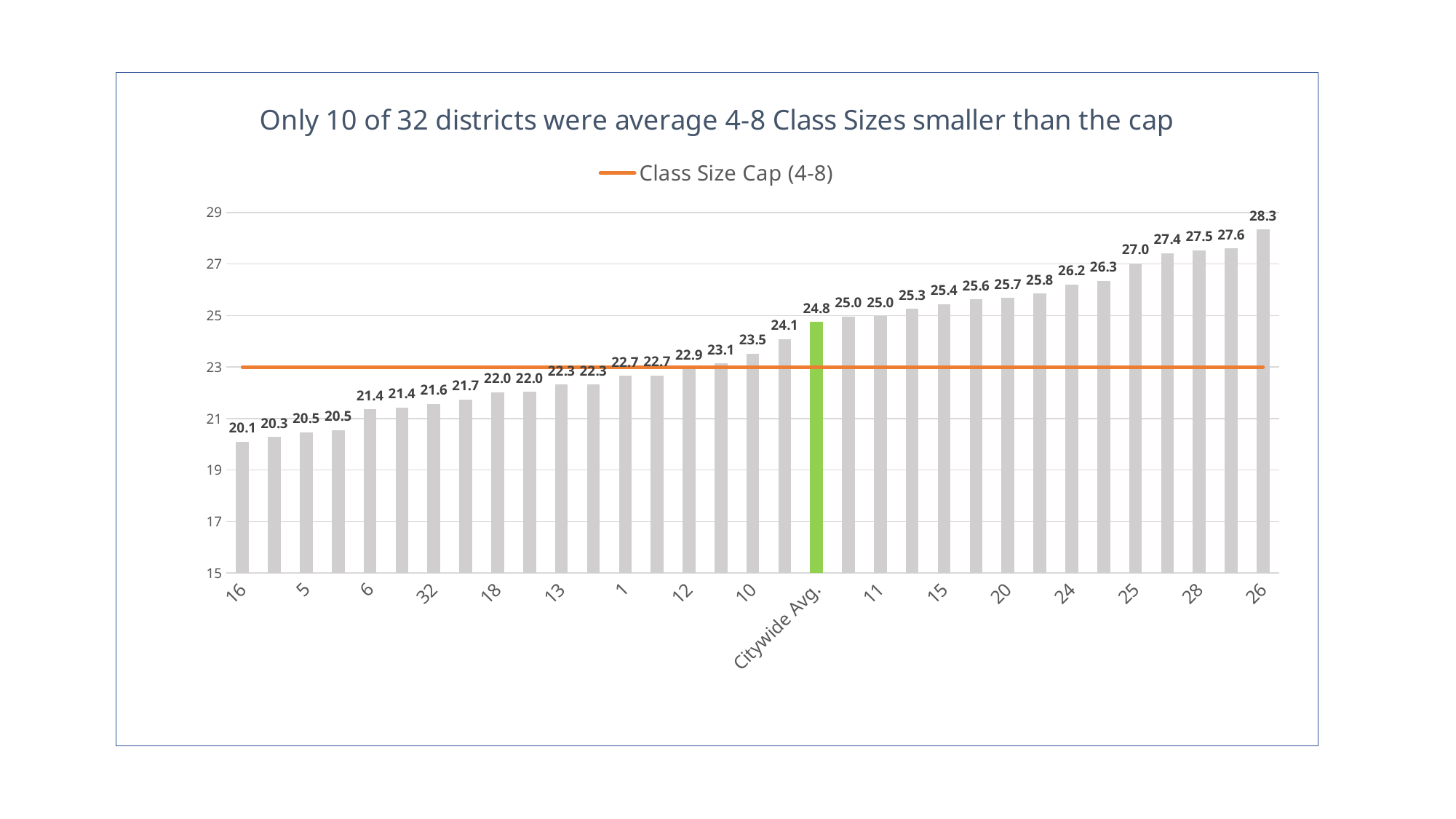
Is the value for district 6 greater or less than 23? less What is the value shown for the Citywide Avg. bar? 24.8 Do the bar values rise or fall from left to right along the x axis? rise What kind of chart is shown on the slide? combination bar and line chart Which has a larger value, district 11 or district 12? 11 Which district has the largest average 4-8 class size? 26 What is the average 4-8 class size for district 26? 28.3 Which district has the smallest average 4-8 class size? 16 What is the label of the line series in the legend? Class Size Cap (4-8) What is the average 4-8 class size for district 16? 20.1 What is the value shown for district 10? 23.5 What is the difference between the values for district 26 and district 16? 8.2